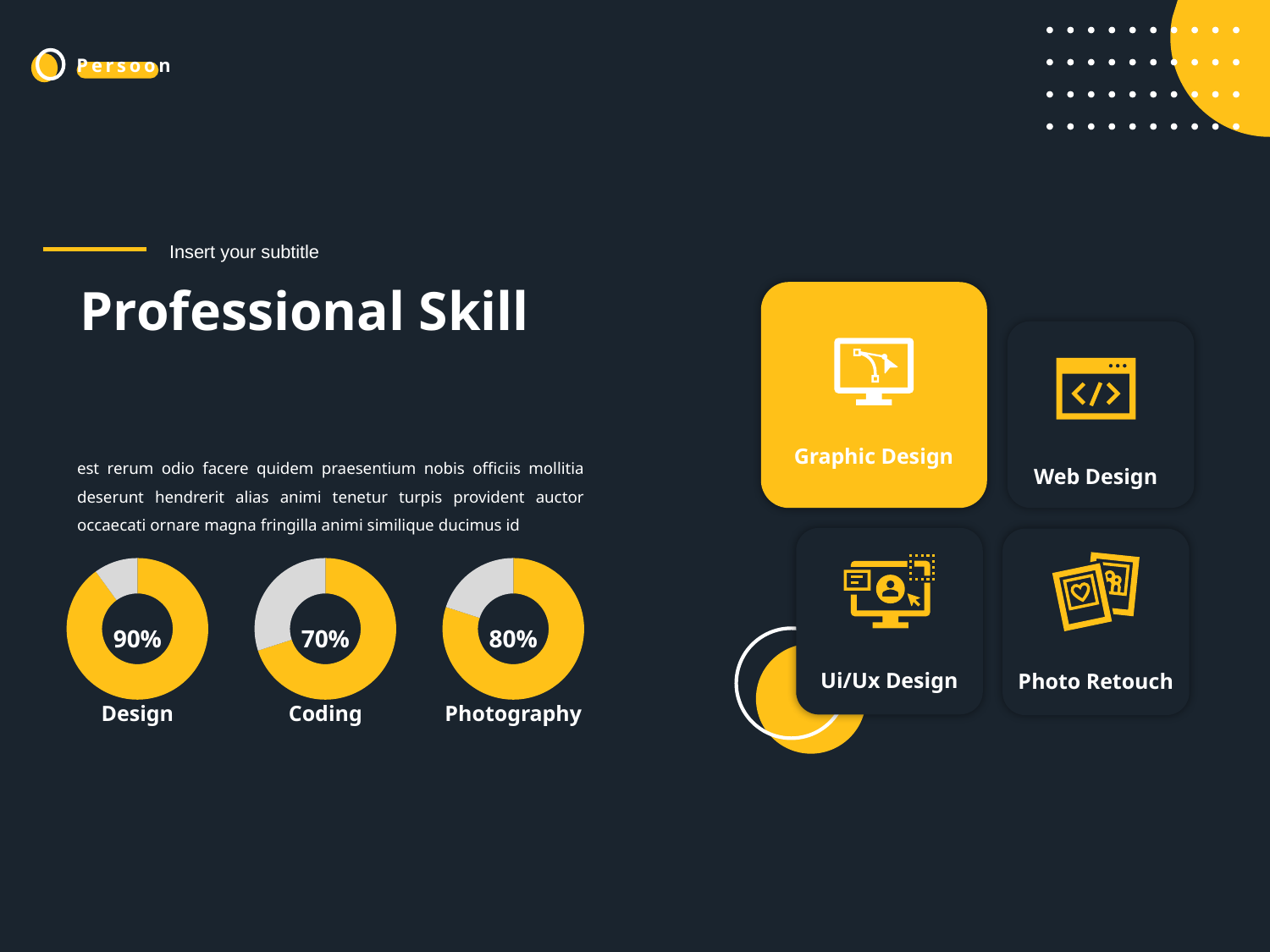
Among the three donut charts (Design, Coding, Photography), which skill has the lowest percentage? Coding Among the three donut charts (Design, Coding, Photography), which skill has the highest percentage? Design What value is shown in the Coding donut chart? 70% What is the difference between the Photography chart's value and the Coding chart's value? 10% How many donut charts are shown on the slide? 3 Which is larger, the value in the Photography chart or the value in the Coding chart? Photography What value is shown in the Design donut chart? 90% What colour is the filled portion of the Design donut chart? Yellow What value is shown in the Photography donut chart? 80% What kind of chart is used to show the Design, Coding and Photography skills? Donut chart What is the difference between the Design chart's value and the Coding chart's value? 20% In the Coding donut chart, what share of the ring is filled in yellow? 70%